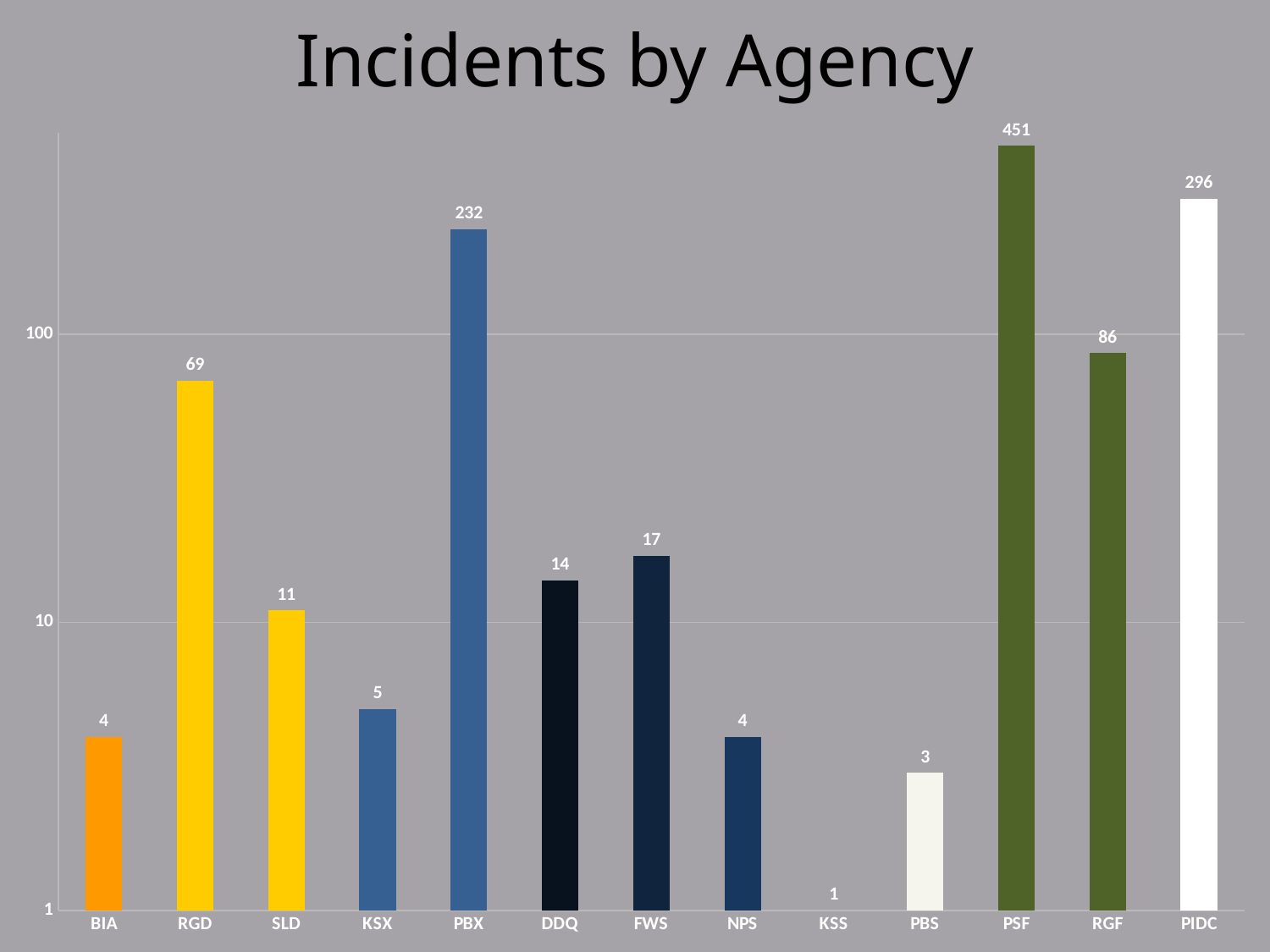
What is the difference in incidents between FWS and DDQ? 3 Which agency has the highest number of incidents? PSF What is the number of incidents for PBS? 3 What is the title of the chart? Incidents by Agency Is the value for SLD greater or less than 10? greater What is the difference in incidents between PSF and PIDC? 155 Which agency has the lowest number of incidents? KSS What kind of chart is shown on the slide? bar chart What is the number of incidents for RGD? 69 Which has more incidents, RGF or RGD? RGF How many agencies are shown on the x axis? 13 What is the number of incidents for PBX? 232